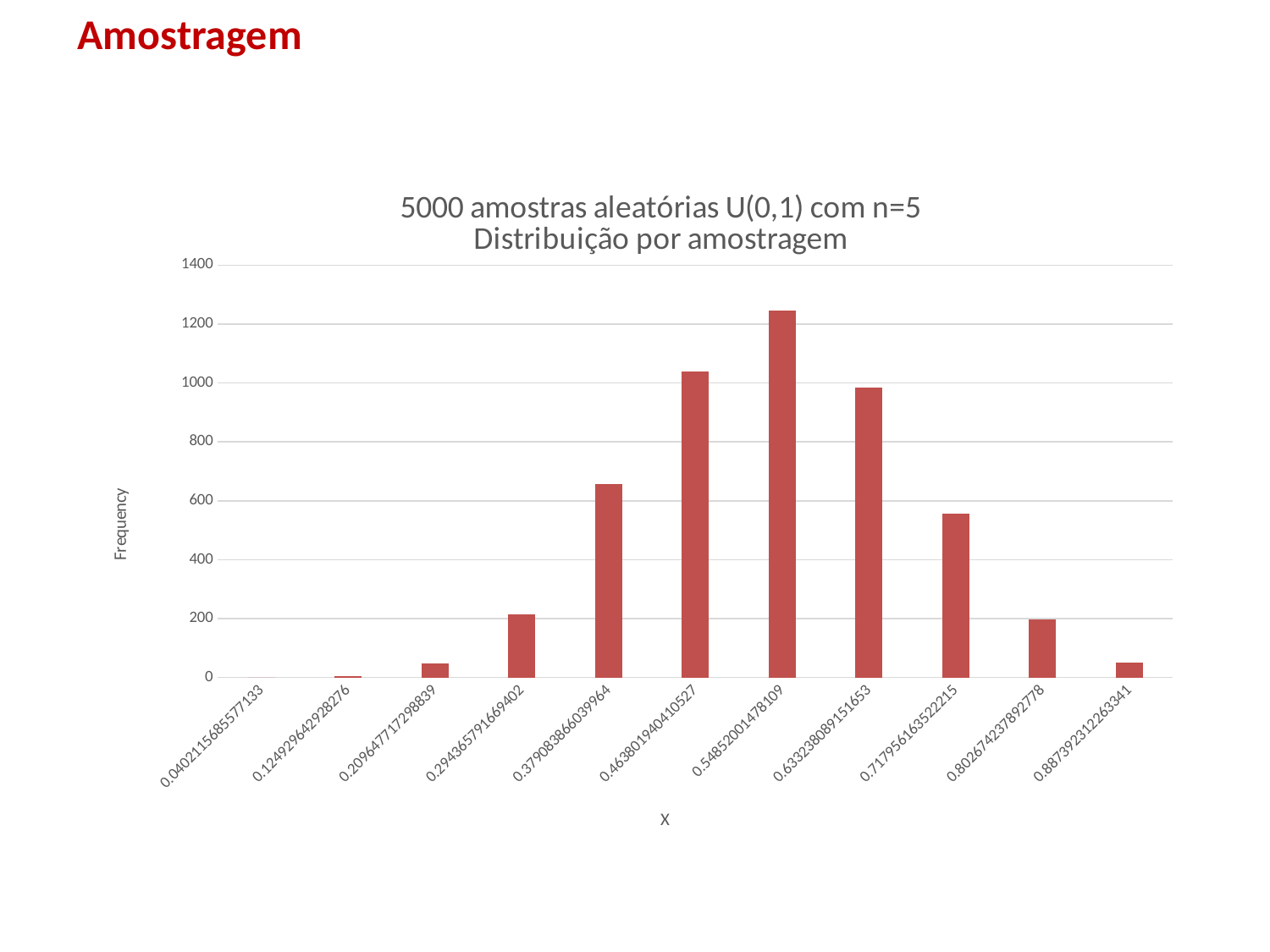
Is the frequency for 0.379083866039964 greater or less than 600? greater Which has the higher frequency, 0.379083866039964 or 0.717956163522215? 0.379083866039964 How many bars (categories) are plotted on the x axis? 11 Is the frequency for 0.548520014781 09 greater or less than 1200? greater Is the frequency for 0.717956163522215 greater or less than 600? less What kind of chart is shown on the slide? Bar chart Which x-axis category has the highest frequency? 0.54852001478109 What is the label on the vertical axis of the chart? Frequency Do the frequencies rise steadily, fall steadily, or rise and then fall along the x axis? Rise and then fall